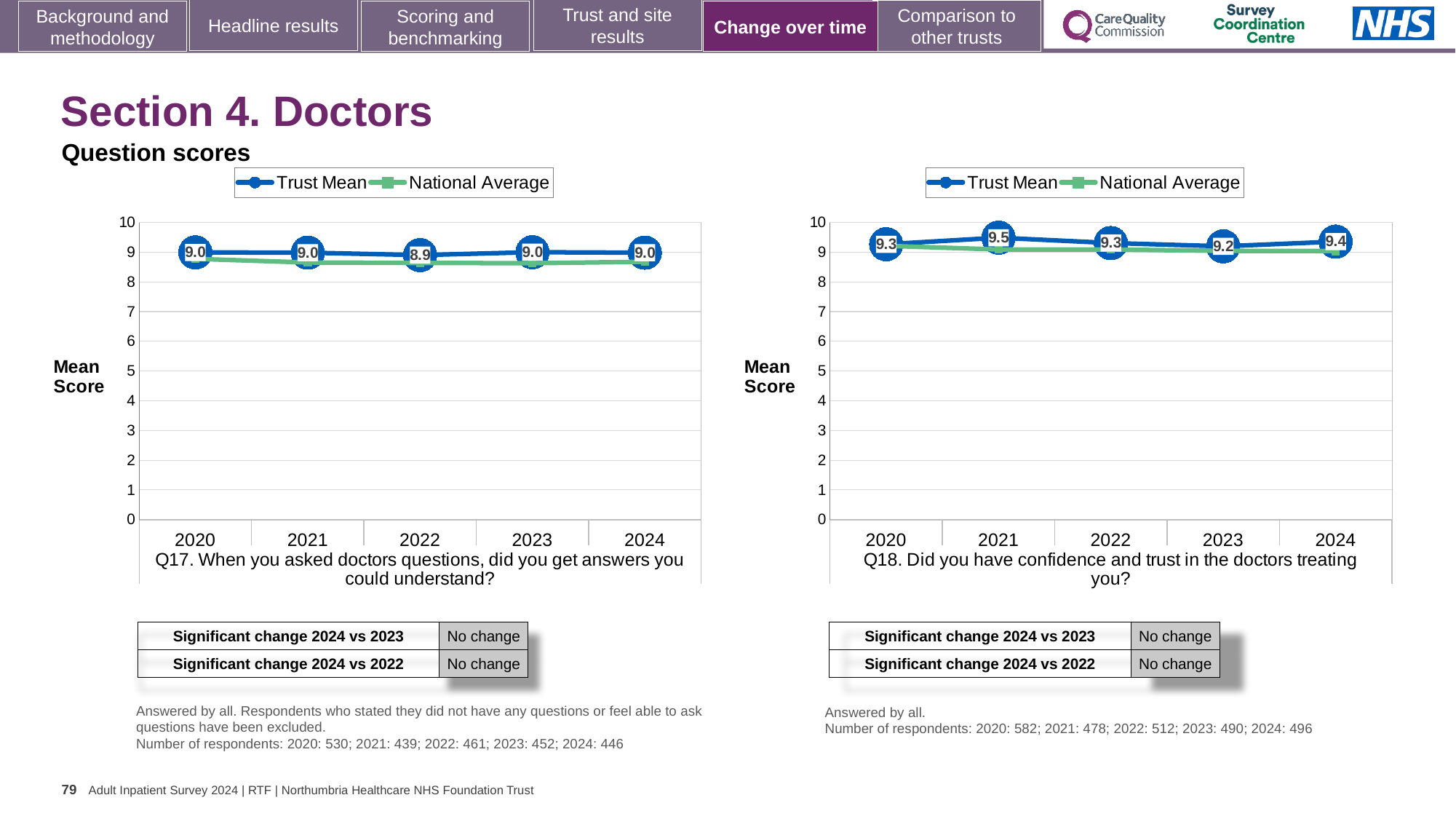
On the Q18 chart, what is the difference between the Trust Mean scores for 2021 and 2023? 0.3 What type of chart is used for Q17? Line chart On the Q17 chart, which year has the lowest Trust Mean score? 2022 On the Q17 chart, is the National Average value for 2024 greater or less than 8? greater On the Q18 chart, is the Trust Mean score for 2021 larger or smaller than the score for 2024? larger On the Q18 chart, what is the Trust Mean score for 2021? 9.5 On the Q17 chart, what is the Trust Mean score for 2022? 8.9 On the Q18 chart, which year has the highest Trust Mean score? 2021 On the Q18 chart, what is the Trust Mean score for 2024? 9.4 On the Q18 chart, which year has the lowest Trust Mean score? 2023 How many series does the legend of the Q18 chart list? 2 How many years are plotted on the Q17 chart? 5